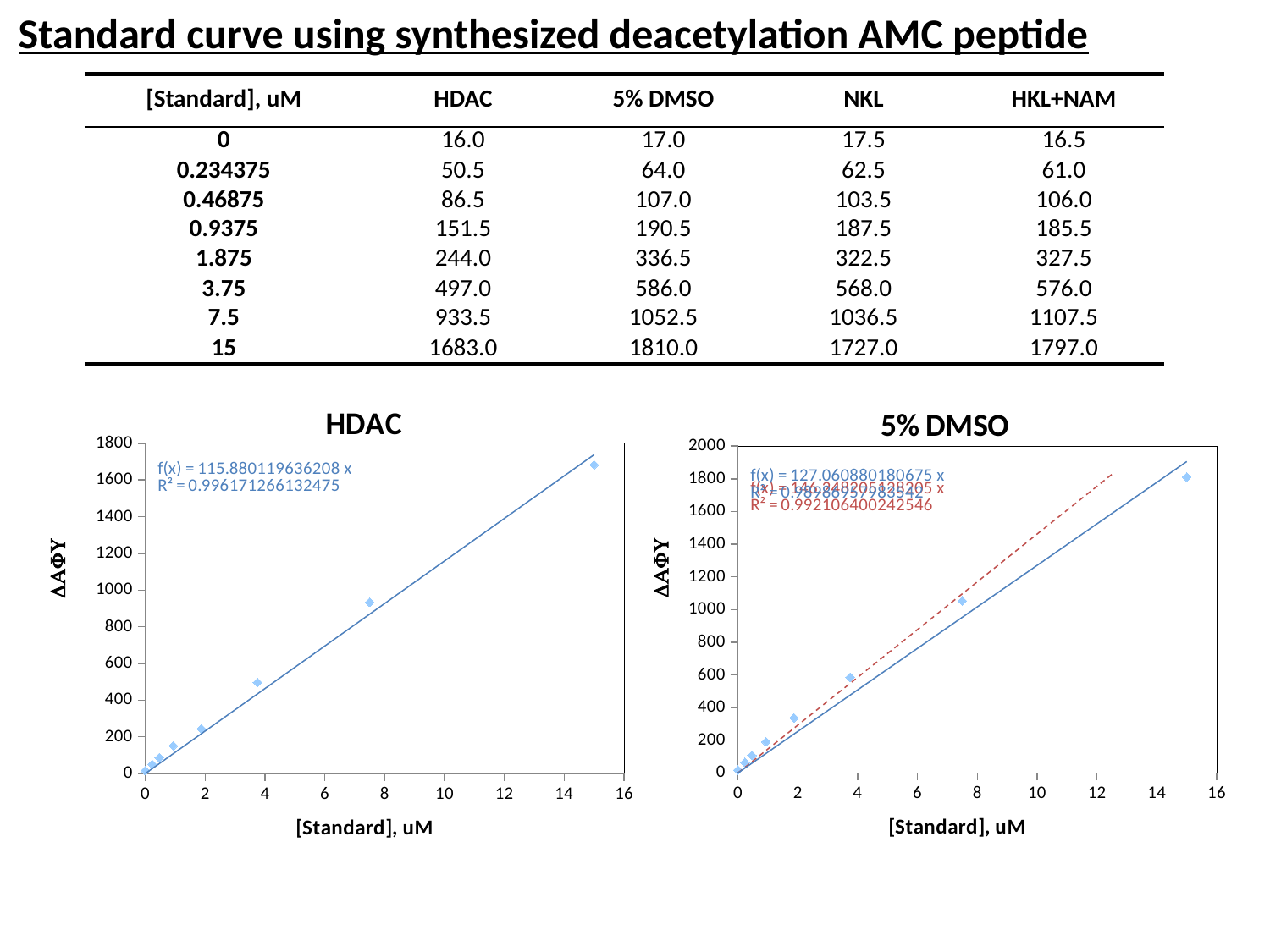
In the HDAC chart, is the value at 7.5 uM greater or less than 1000? less What is the x-axis label of the HDAC chart? [Standard], uM According to the table, what is the HDAC value at 15 uM standard? 1683.0 In the 5% DMSO chart, do the values rise or fall as [Standard], uM increases? rise What kind of chart is the HDAC chart? scatter chart In the 5% DMSO chart, is the value at 15 uM greater or less than 1600? greater According to the table, which is larger at 1.875 uM: the HDAC value or the 5% DMSO value? 5% DMSO According to the table, what is the 5% DMSO value at 7.5 uM standard? 1052.5 What is the title of the chart on the right? 5% DMSO In the HDAC chart, is the value at 15 uM greater or less than 1600? greater How many data points are plotted in the HDAC chart? 8